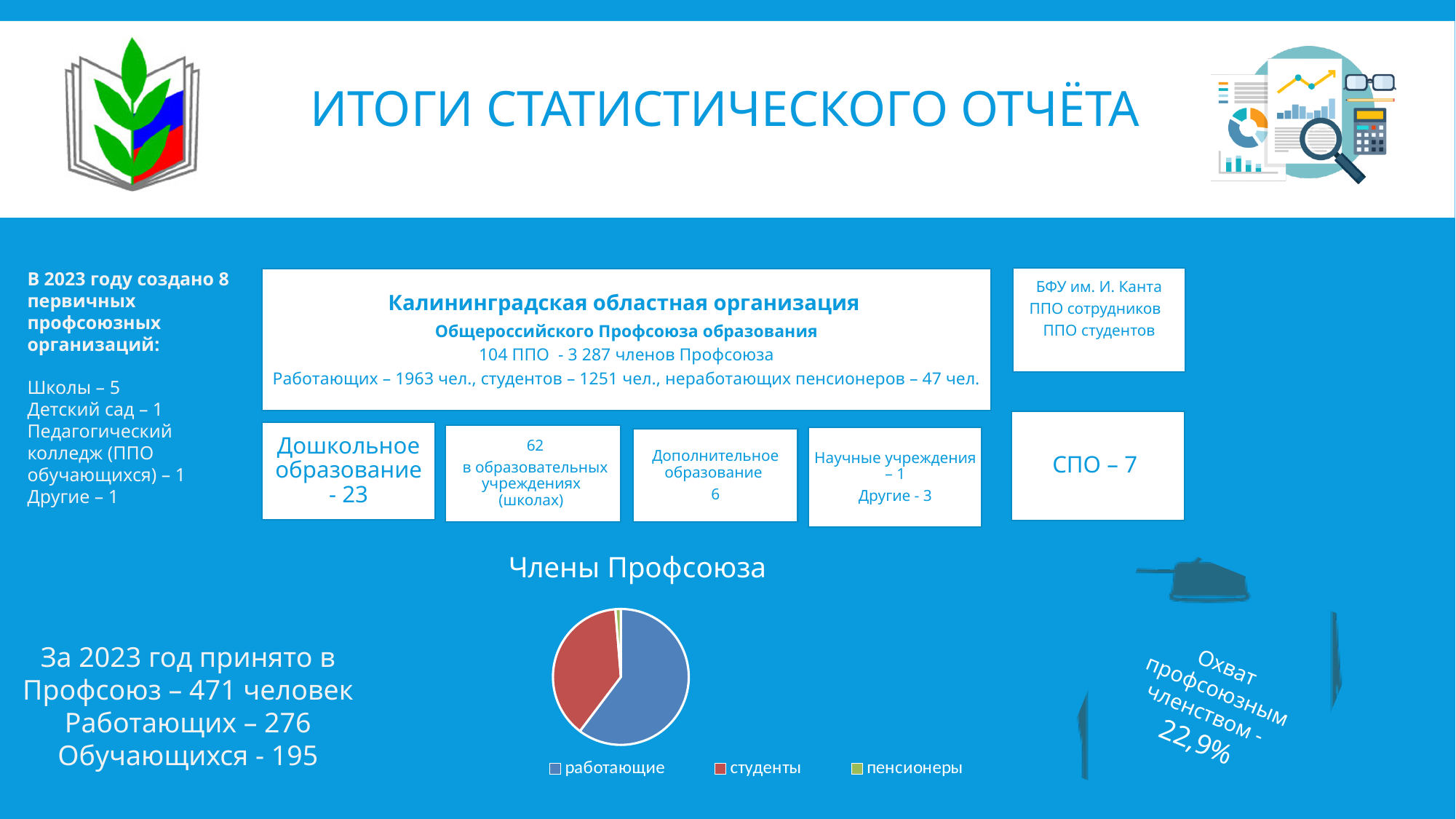
What colour is the студенты slice in the pie chart "Члены Профсоюза"? red What is the title of the pie chart on the slide? Члены Профсоюза How many entries does the legend of the pie chart "Члены Профсоюза" list? 3 Which category has the smallest slice in the pie chart "Члены Профсоюза"? пенсионеры In the pie chart "Члены Профсоюза", does the работающие slice take up more or less than half of the pie? more In the pie chart "Члены Профсоюза", which slice is larger: студенты or пенсионеры? студенты What kind of chart is shown under the heading "Члены Профсоюза"? pie chart How many slices does the pie chart "Члены Профсоюза" have? 3 Which category has the largest slice in the pie chart "Члены Профсоюза"? работающие In the pie chart "Члены Профсоюза", which slice is larger: работающие or студенты? работающие